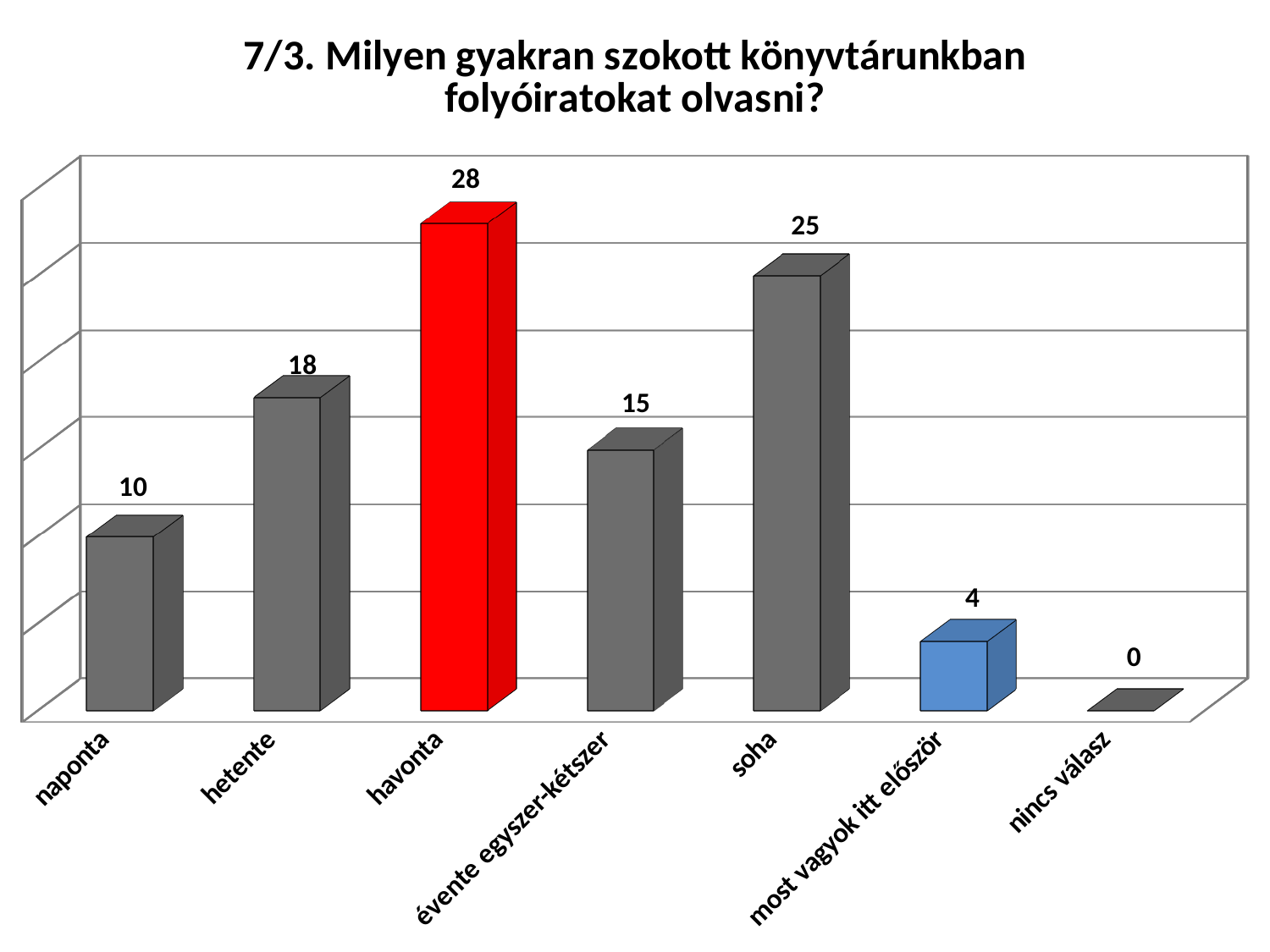
What is the value for "most vagyok itt először"? 4 What is the value for "soha"? 25 What kind of chart is shown on the slide? bar chart Which category has the highest value? havonta Which category has the lowest value? nincs válasz Which is larger, the value for "hetente" or the value for "évente egyszer-kétszer"? hetente How many categories are shown on the x axis? 7 What is the difference between the values for "hetente" and "naponta"? 8 What is the value for "havonta"? 28 What is the difference between the values for "havonta" and "soha"? 3 Which category's bar is coloured red? havonta What is the title of the chart? 7/3. Milyen gyakran szokott könyvtárunkban folyóiratokat olvasni?